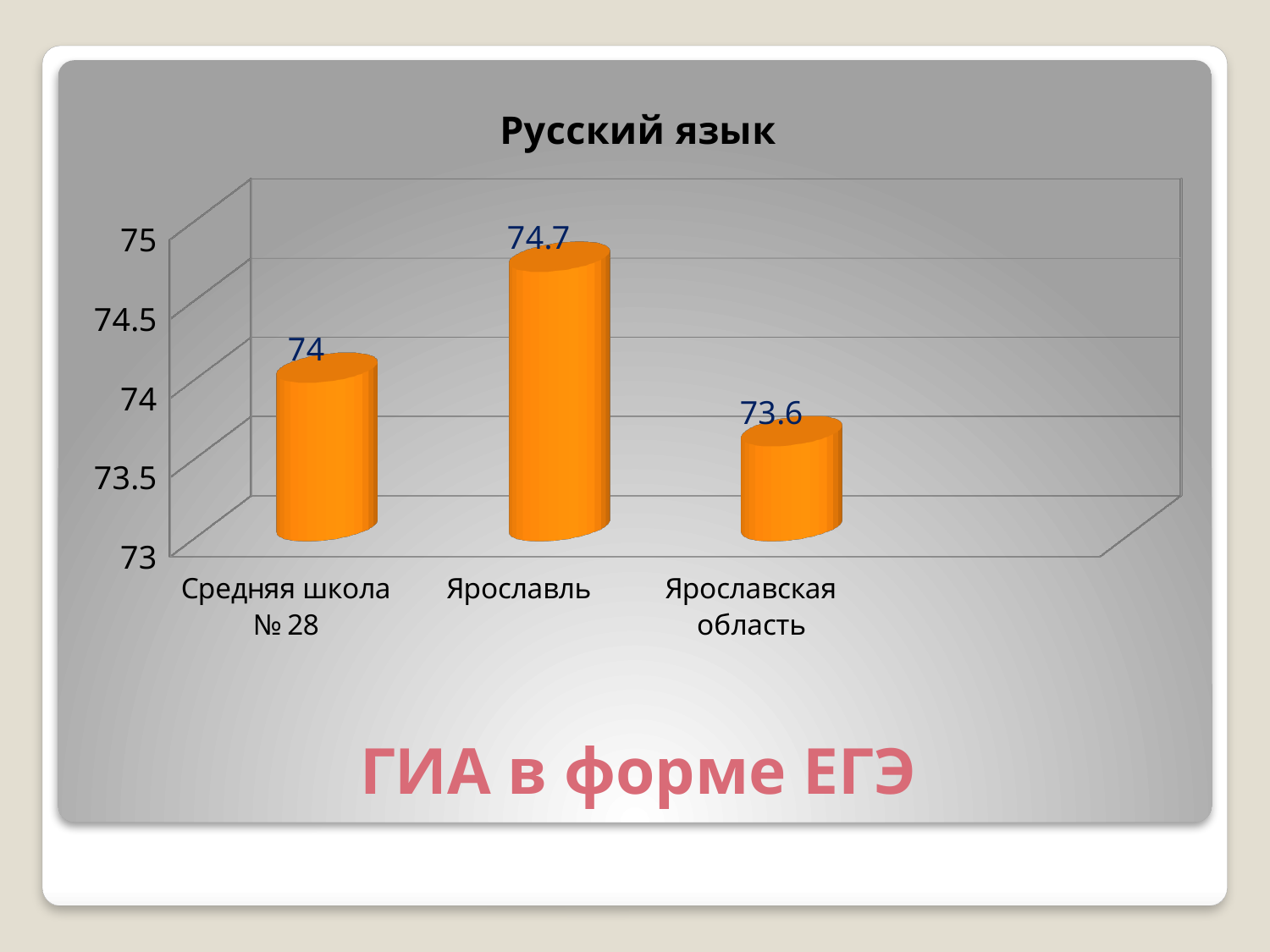
What is the value for Ярославль? 74.7 Is the value for Ярославская область greater or less than 74? less Which category has the highest value? Ярославль Which category has the lowest value? Ярославская область What kind of chart is shown on the slide? bar chart Which is larger, the value for Ярославль or the value for Ярославская область? Ярославль What is the value for Средняя школа № 28? 74 What is the difference between the values for Средняя школа № 28 and Ярославская область? 0.4 How many categories are shown in the chart? 3 What is the title of the chart? Русский язык What is the value for Ярославская область? 73.6 What is the difference between the values for Ярославль and Средняя школа № 28? 0.7